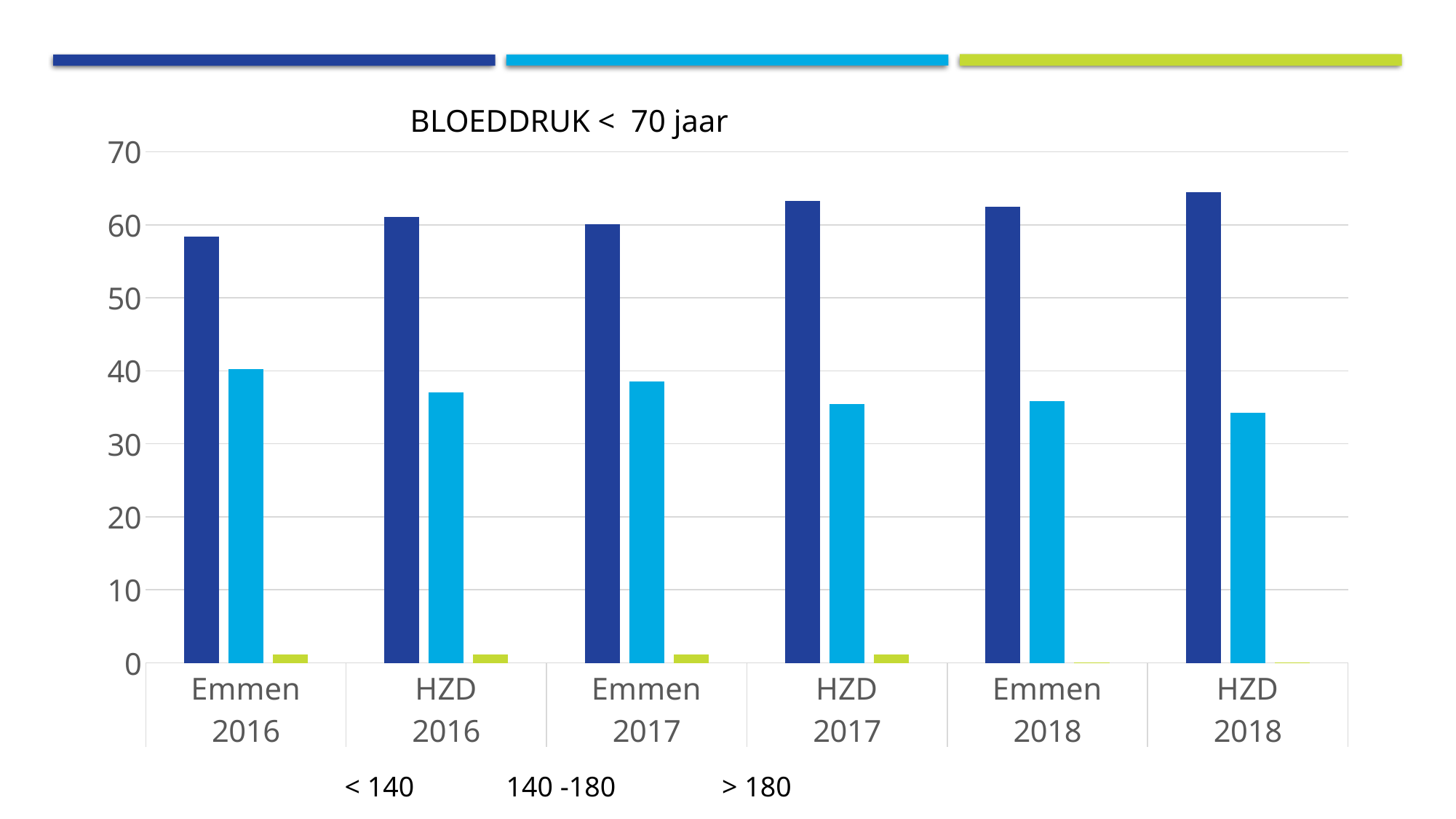
Is the value for > 180 at Emmen 2017 greater or less than 10? less What kind of chart is shown on the slide? bar chart Is the value for 140 -180 at HZD 2018 greater or less than 40? less What is the title of the chart? BLOEDDRUK < 70 jaar Which is larger for the < 140 series: Emmen 2016 or HZD 2016? HZD 2016 How many categories are shown on the x axis? 6 Is the value for < 140 at Emmen 2016 greater or less than 50? greater Which category has the highest value for the < 140 series? HZD 2018 Which category has the highest value for the 140 -180 series? Emmen 2016 How many series does the legend list? 3 Which category has the lowest value for the < 140 series? Emmen 2016 Which series is shown in green? > 180